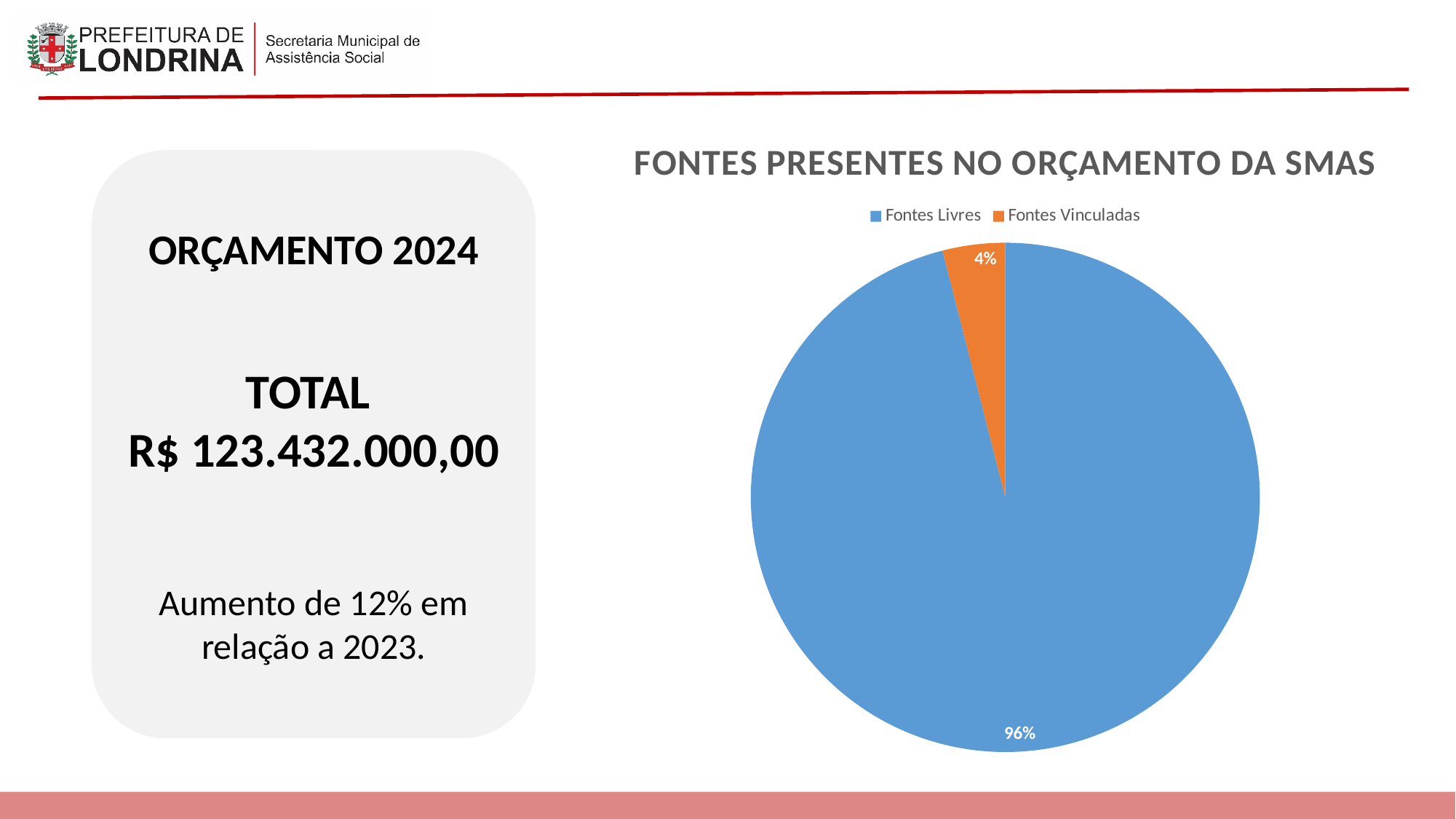
What is the difference in percentage points between Fontes Livres and Fontes Vinculadas? 92 How many entries does the chart legend list? 2 Which is larger, Fontes Livres or Fontes Vinculadas? Fontes Livres What colour is the Fontes Vinculadas slice? orange What type of chart is shown on the slide? pie chart What share of the pie does Fontes Livres represent? 96% Which slice of the pie is the smallest? Fontes Vinculadas Which slice of the pie is the largest? Fontes Livres How many slices does the pie chart have? 2 What is the title of the chart? FONTES PRESENTES NO ORÇAMENTO DA SMAS What share of the pie does Fontes Vinculadas represent? 4%